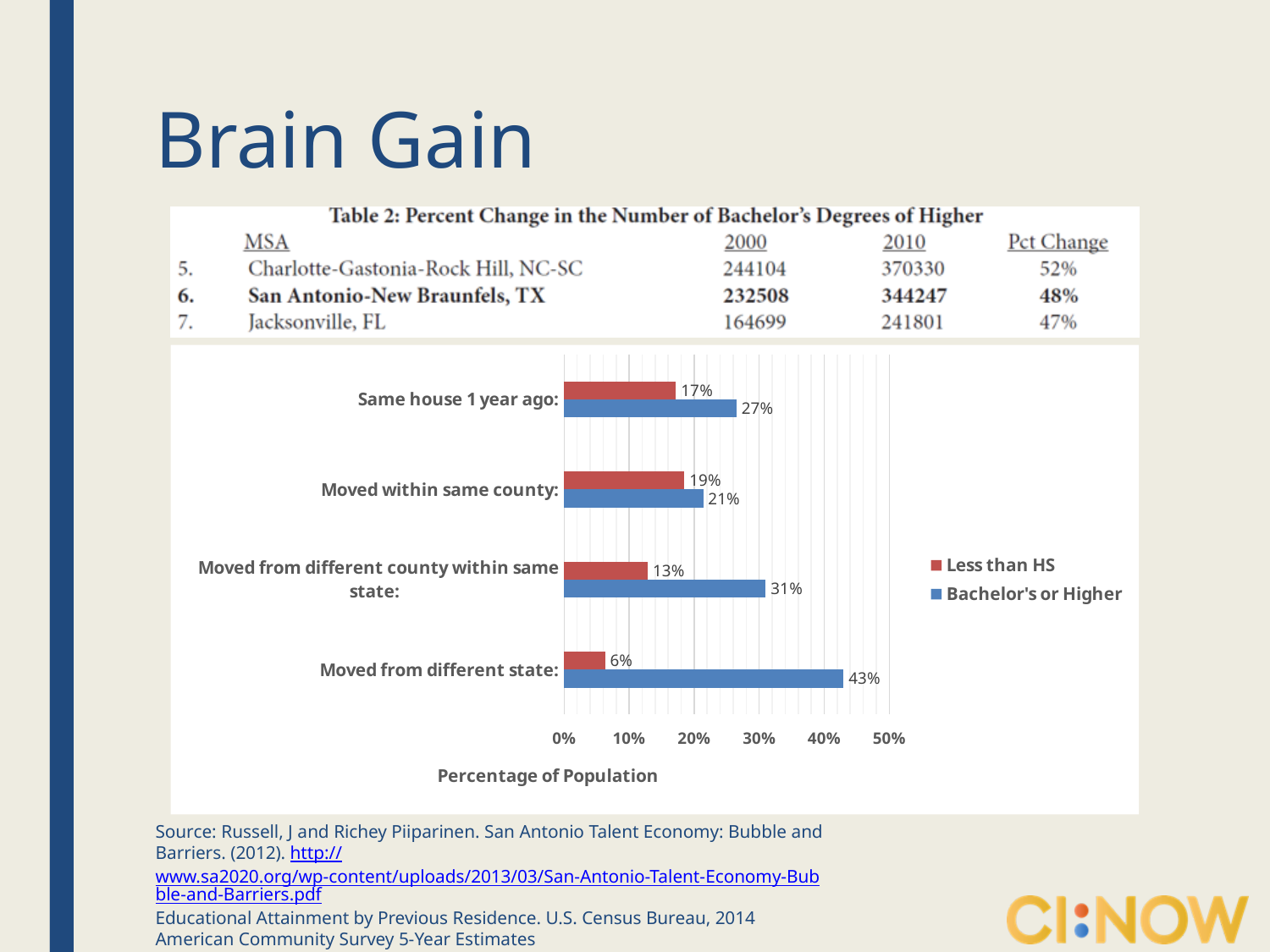
How many categories are shown on the bar chart? 4 How many series does the legend list? 2 What is the label on the horizontal axis of the bar chart? Percentage of Population Which is larger for 'Moved within same county': Less than HS or Bachelor's or Higher? Bachelor's or Higher What kind of chart is shown below the table? Bar chart Is the Bachelor's or Higher value for 'Moved from different state' greater or less than 40%? greater What is the value for Bachelor's or Higher in the 'Moved from different state' category? 43% What is the value for Less than HS in the 'Same house 1 year ago' category? 17% Which category has the lowest Less than HS value? Moved from different state Which category has the highest Bachelor's or Higher value? Moved from different state What is the value for Less than HS in the 'Moved from different county within same state' category? 13% What is the difference between the Bachelor's or Higher and Less than HS values for 'Moved from different state'? 37%